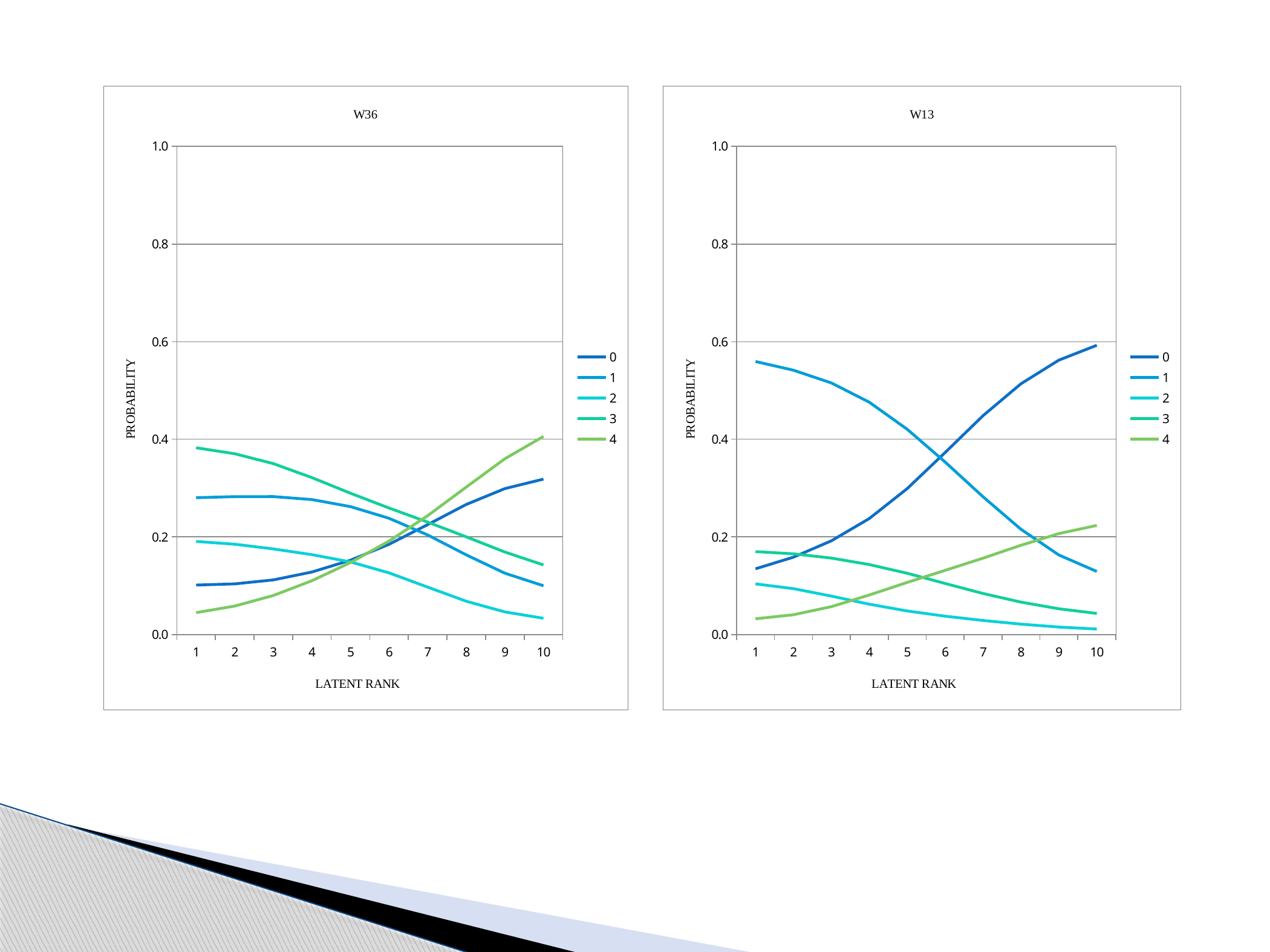
In the W13 chart, does series 0 rise or fall as latent rank increases from 1 to 10? rises In the W13 chart, at latent rank 10, which is larger: series 0 or series 1? series 0 In the W13 chart, which series has the highest value at latent rank 1? 1 What is the x-axis title of the W13 chart? LATENT RANK What kind of chart is the W36 chart? line chart How many latent rank values are shown on the x axis of the W13 chart? 10 How many series does the legend of the W36 chart list? 5 In the W36 chart, which series has the lowest value at latent rank 10? 2 In the W13 chart, is the value for series 1 at latent rank 1 greater or less than 0.4? greater What is the y-axis title of the W36 chart? PROBABILITY In the W36 chart, does series 3 rise or fall as latent rank increases from 1 to 10? falls In the W36 chart, is the value for series 4 at latent rank 1 greater or less than 0.2? less